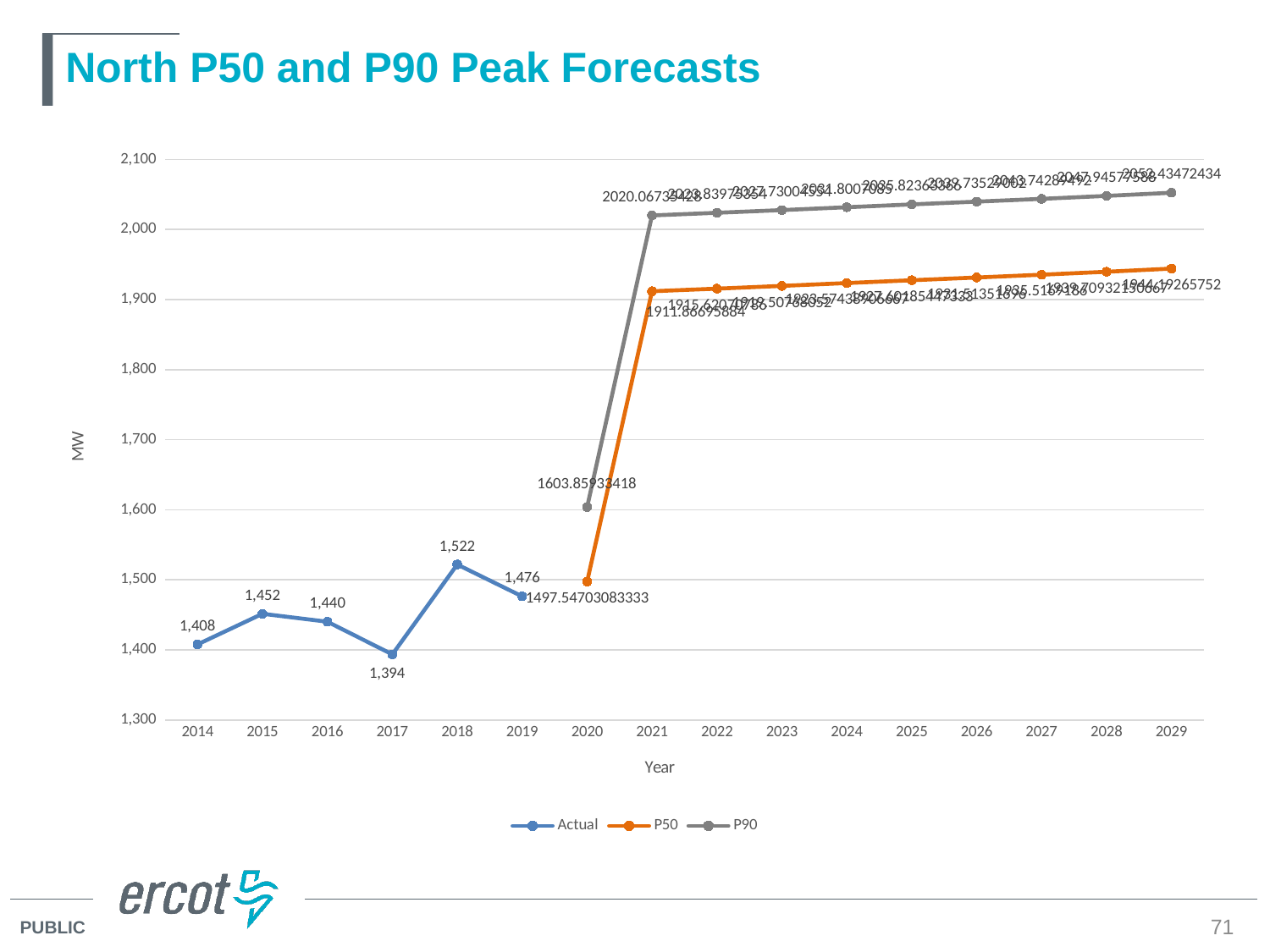
What is the Actual value for 2014? 1,408 How many series does the legend list? 3 What is the Actual value for 2017? 1,394 Is the P90 value for 2025 greater or less than 2,000? greater What is the difference between the Actual values for 2018 and 2017? 128 Which is larger, the Actual value for 2015 or for 2016? 2015 Which year has the highest Actual value? 2018 What is the Actual value for 2018? 1,522 What is the P50 value for 2029? 1944.19265752 Which year has the lowest Actual value? 2017 What type of chart is shown on the slide? line chart What is the P90 value for 2020? 1603.85933418